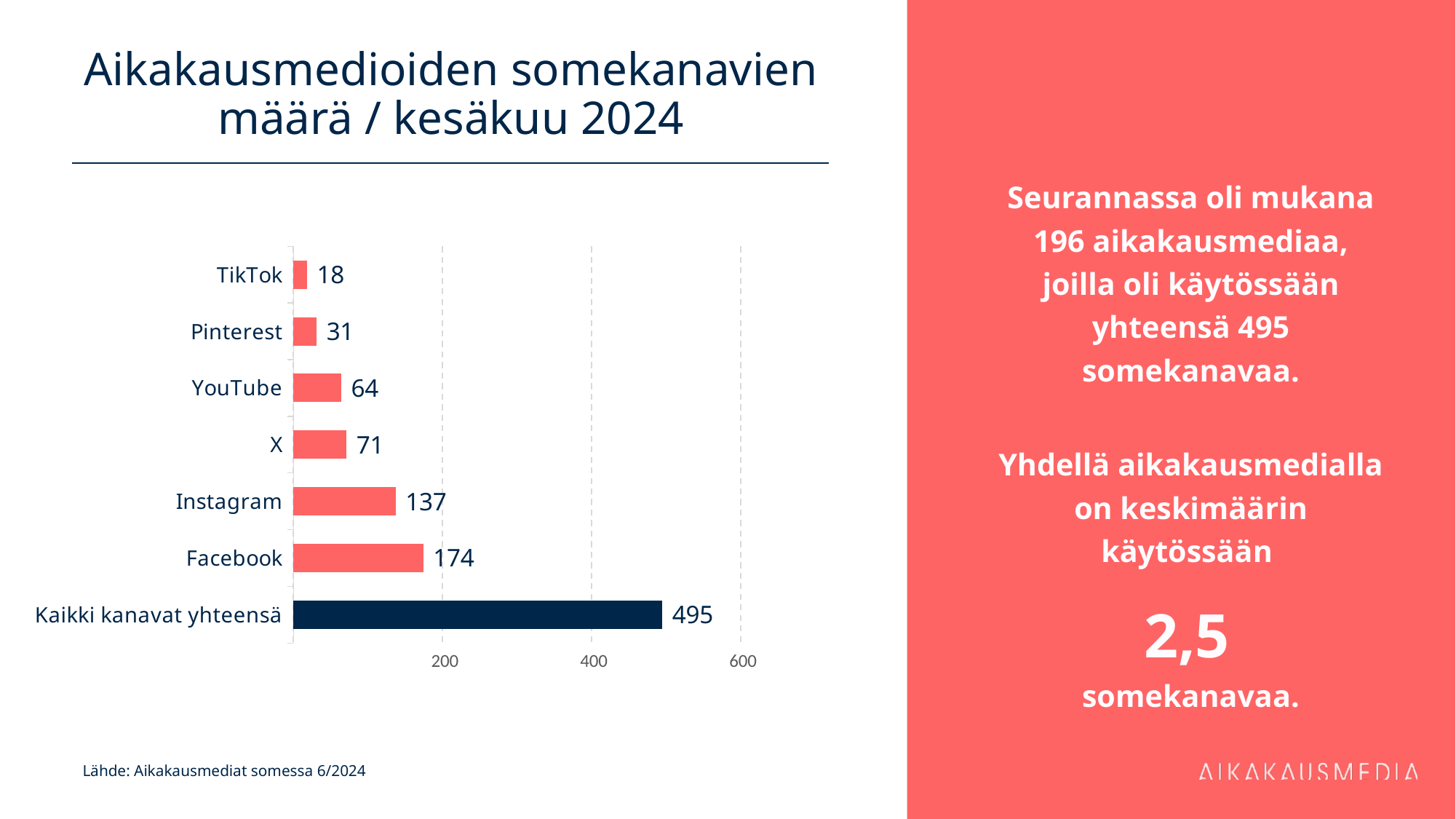
What is the value for Kaikki kanavat yhteensä? 495 How many categories are shown in the chart? 7 What is the value for Facebook? 174 Which individual channel (excluding the total bar) has the highest value? Facebook What is the difference between the values for X and YouTube? 7 What is the title of the chart on the slide? Aikakausmedioiden somekanavien määrä / kesäkuu 2024 What is the difference between the values for Facebook and Instagram? 37 What kind of chart is shown on the slide? Bar chart Which category has the lowest value? TikTok What is the value for TikTok? 18 Which is larger, the value for Pinterest or the value for YouTube? YouTube What is the value for Instagram? 137